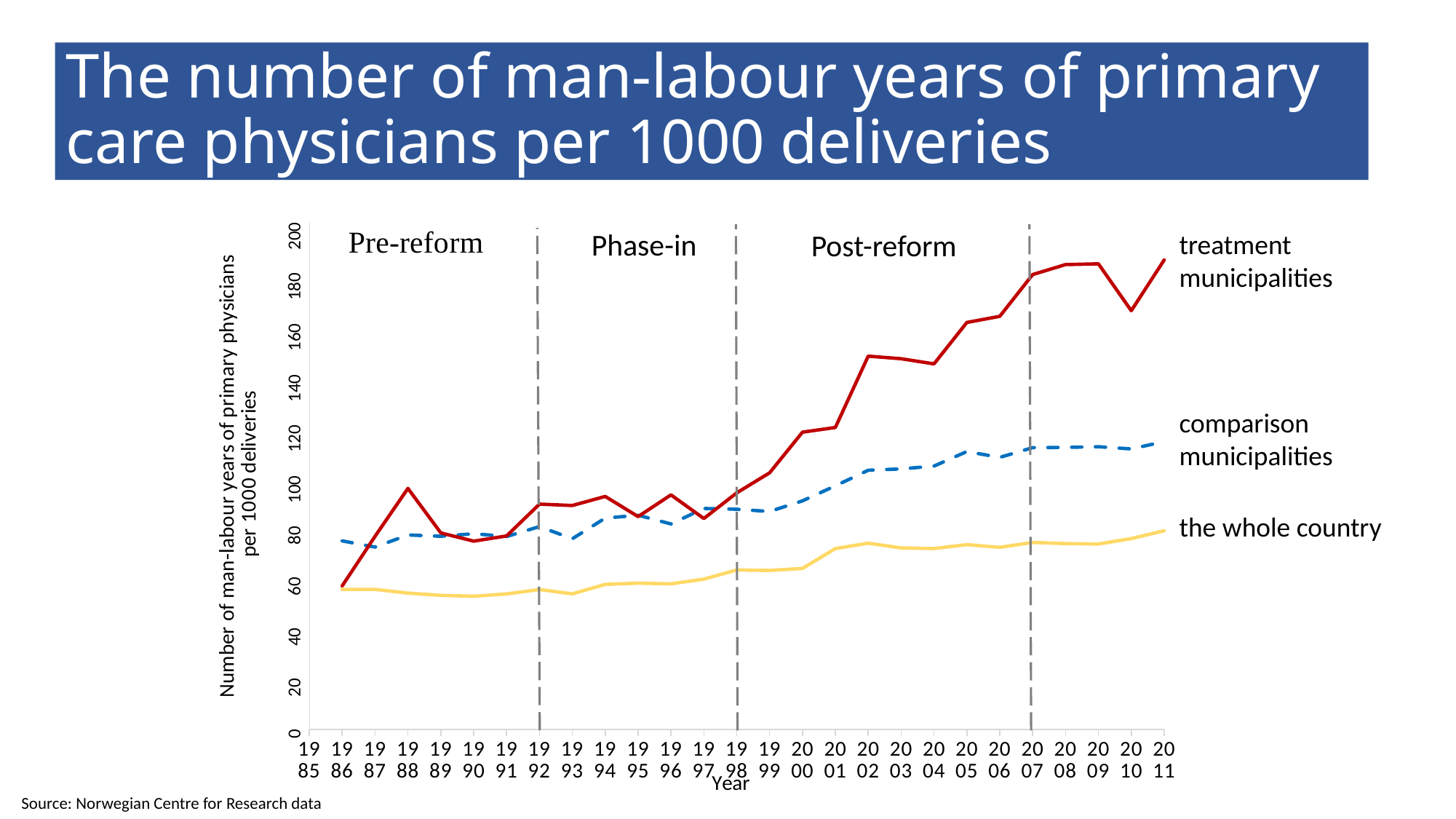
Is the value for treatment municipalities in 2010 greater or less than 180? less Is the value for treatment municipalities in 2002 greater or less than 140? greater Is the value for treatment municipalities in 2011 greater or less than 180? greater Do the values for treatment municipalities rise or fall between 1998 and 2007? rise In 1986, which is larger: the value for comparison municipalities or the value for treatment municipalities? comparison municipalities What are the three periods labelled across the top of the chart? Pre-reform, Phase-in, Post-reform Which series has the lowest value in 2011? the whole country Which series has the highest value in 2011? treatment municipalities How many series are plotted on the chart? 3 What kind of chart is shown on the slide? line chart